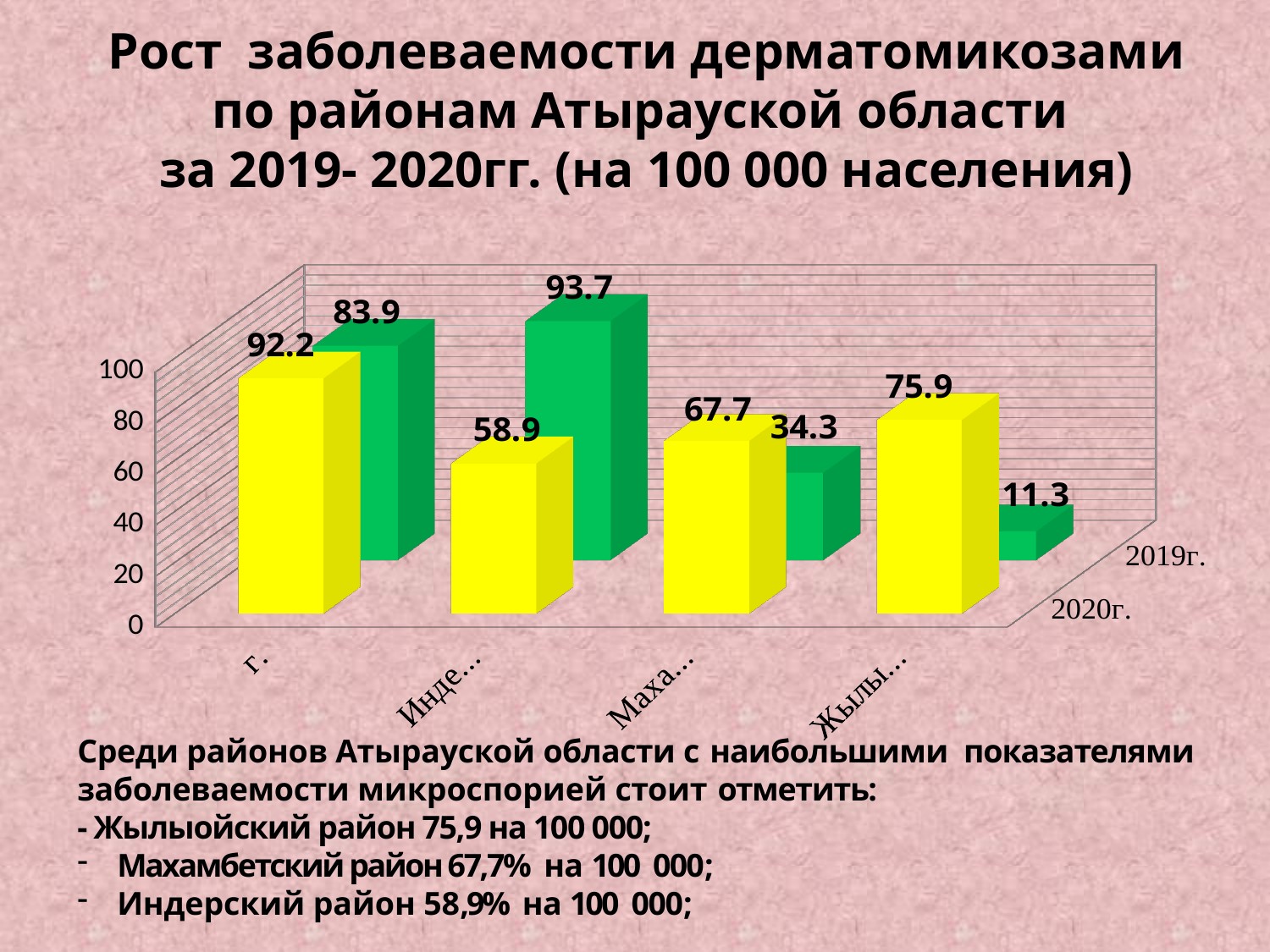
What kind of chart is shown on the slide? Bar chart How many categories (districts) are plotted along the x axis of the chart? 4 For the category "Маха...", what is the difference between the 2020г. value and the 2019г. value? 33.4 What is the 2020г. value for the first category ("г.") in the chart? 92.2 For the category "Жылы...", which series has the larger value, 2019г. or 2020г.? 2020г. What is the 2019г. value for the category "Инде..." in the chart? 93.7 What colour are the bars for the 2020г. series in the chart? Yellow For the category "Жылы...", by how much does the 2020г. value exceed the 2019г. value? 64.6 Which category has the lowest 2020г. value in the chart? Инде... Which category has the highest 2019г. value in the chart? Инде... What is the 2019г. value for the category "Жылы..." in the chart? 11.3